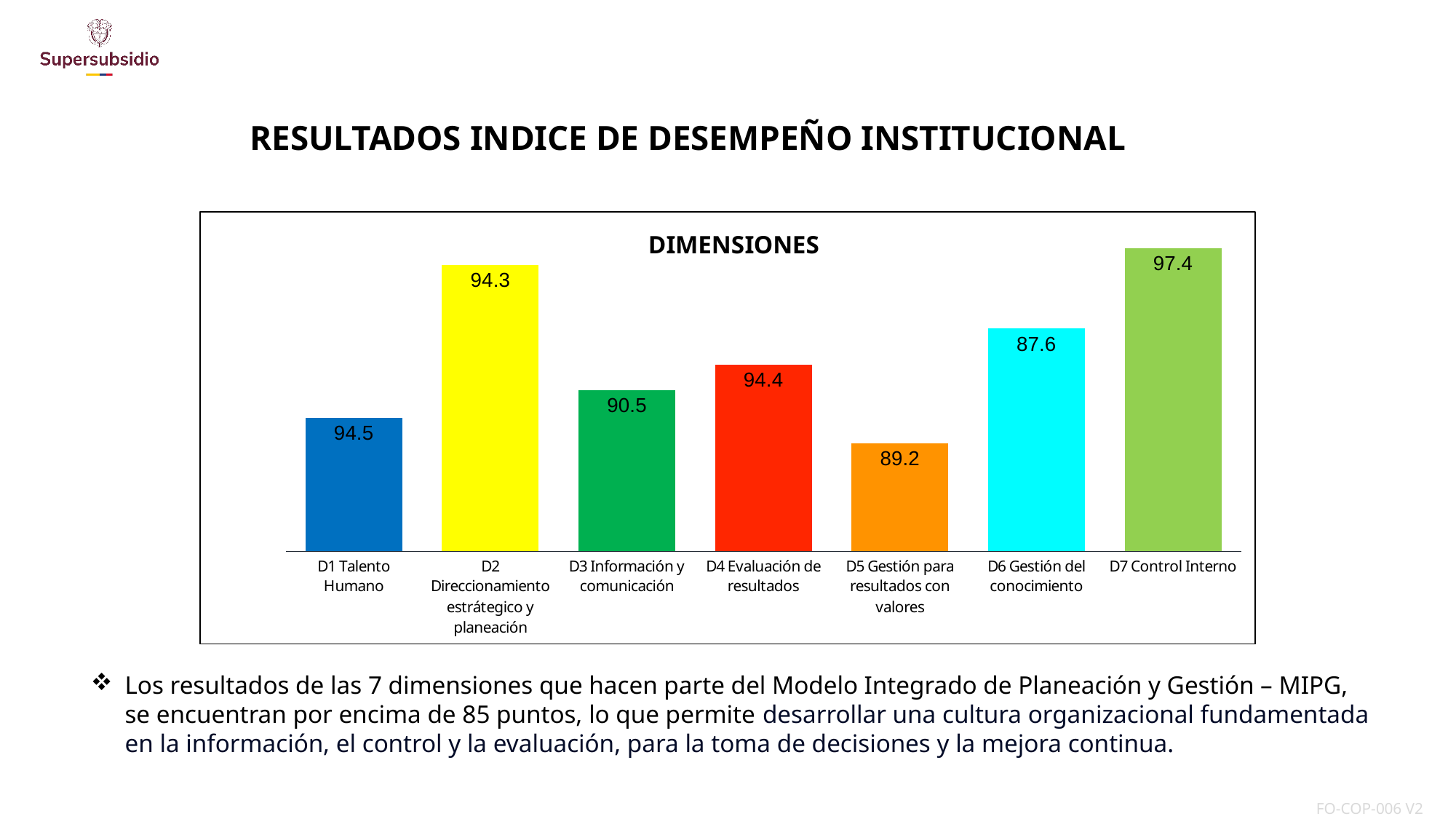
What is the value for D5 Gestión para resultados con valores? 89.2 Which is larger, the value for D3 Información y comunicación or D5 Gestión para resultados con valores? D3 Información y comunicación What is the value for D7 Control Interno? 97.4 Which dimension has the highest value? D7 Control Interno What is the difference between the values for D4 Evaluación de resultados and D5 Gestión para resultados con valores? 5.2 What is the value for D3 Información y comunicación? 90.5 Which is larger, the value for D6 Gestión del conocimiento or D7 Control Interno? D7 Control Interno How many dimensions are shown in the chart? 7 What is the difference between the values for D7 Control Interno and D6 Gestión del conocimiento? 9.8 What is the value for D6 Gestión del conocimiento? 87.6 What is the title of the chart? DIMENSIONES What kind of chart is shown on the slide? Bar chart